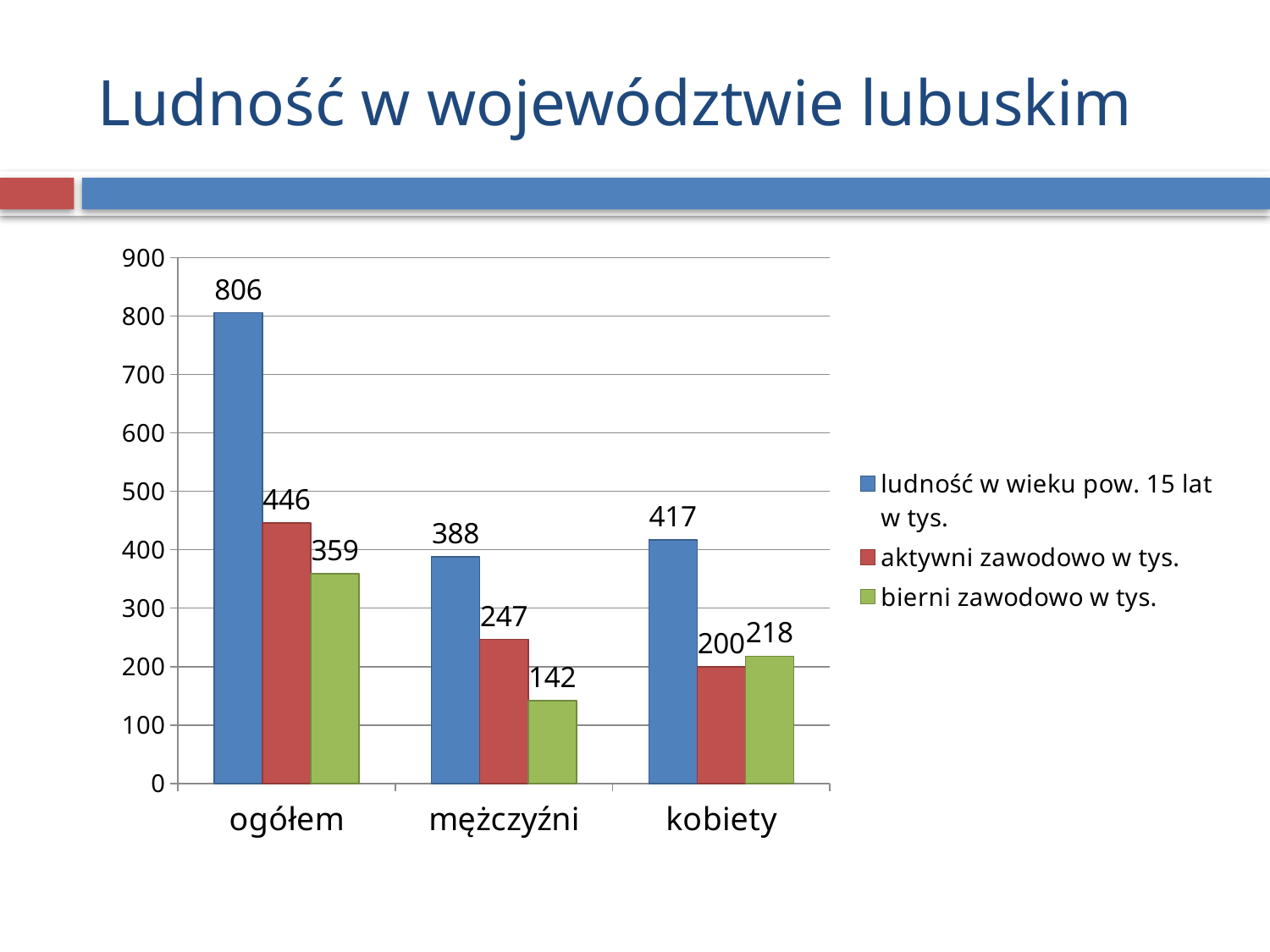
What is the value of 'aktywni zawodowo w tys.' for mężczyźni? 247 What is the value of 'bierni zawodowo w tys.' for kobiety? 218 What kind of chart is shown on the slide? bar chart What is the title of the slide? Ludność w województwie lubuskim Which category has the highest value for 'bierni zawodowo w tys.'? ogółem Which category has the lowest value for 'aktywni zawodowo w tys.'? kobiety What is the difference between 'ludność w wieku pow. 15 lat w tys.' for kobiety and for mężczyźni? 29 Which is larger: 'aktywni zawodowo w tys.' for mężczyźni or 'bierni zawodowo w tys.' for mężczyźni? aktywni zawodowo w tys. How many categories are shown on the x axis? 3 What colour are the bars for 'aktywni zawodowo w tys.'? red What is the value of 'ludność w wieku pow. 15 lat w tys.' for ogółem? 806 How many series does the legend list? 3